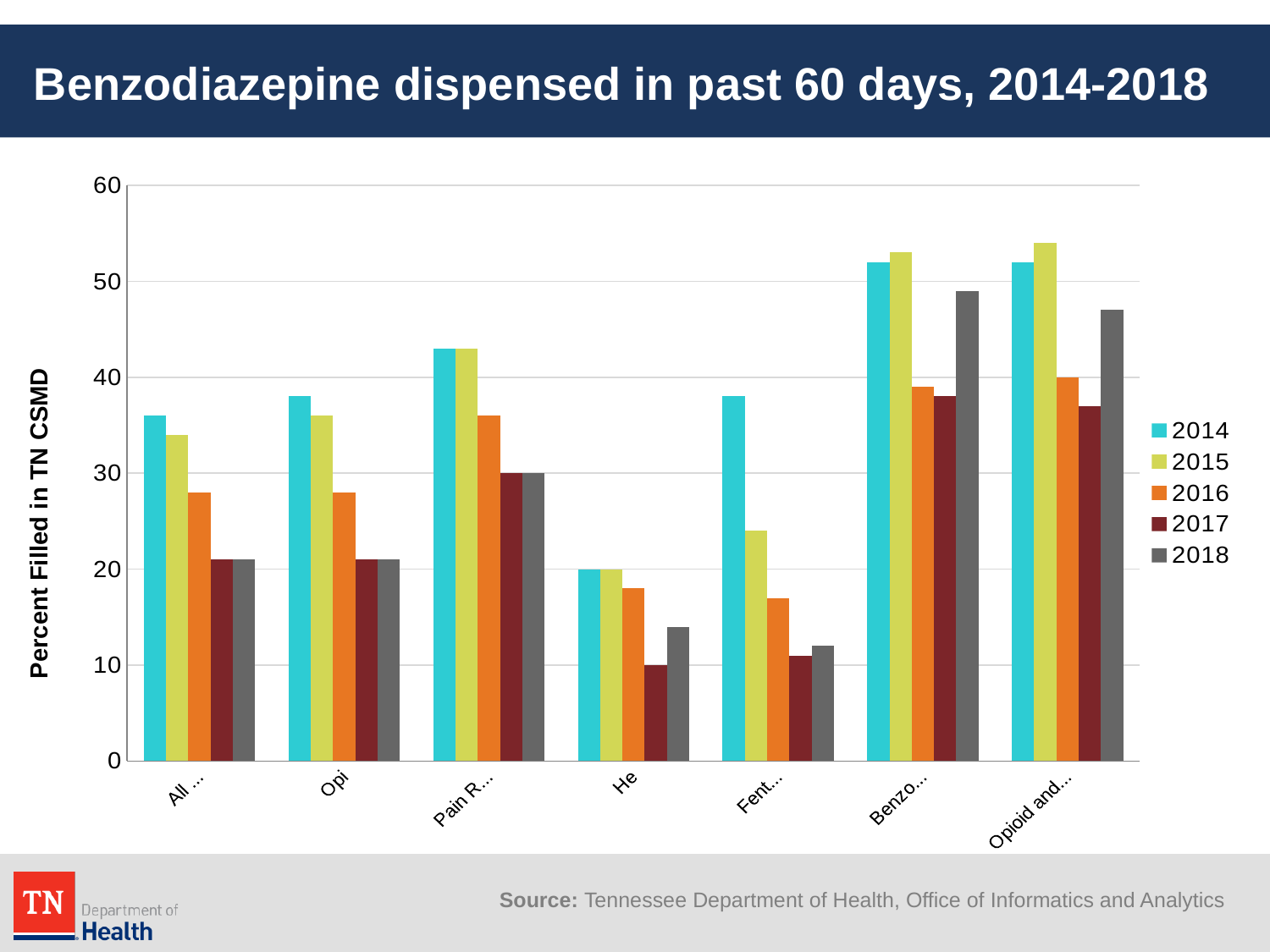
Is the 2015 value for the category labelled "Opioid and..." greater or less than 50? greater How many categories are shown along the x axis? 7 How many series does the legend list? 5 What is the title of the y axis? Percent Filled in TN CSMD Is the 2014 value for the category labelled "He" greater or less than 30? less What kind of chart is shown on the slide? bar chart Which year has the highest value for the category labelled "Fent..."? 2014 Which year has the lowest value for the category labelled "He"? 2017 For the category labelled "Opi", which is larger: the 2014 value or the 2018 value? 2014 For 2016, which is larger: the value for "Pain R..." or the value for "He"? Pain R... For the category labelled "Opi", do the values rise or fall from 2014 to 2017? fall Is the 2018 value for the category labelled "Benzo..." greater or less than 40? greater